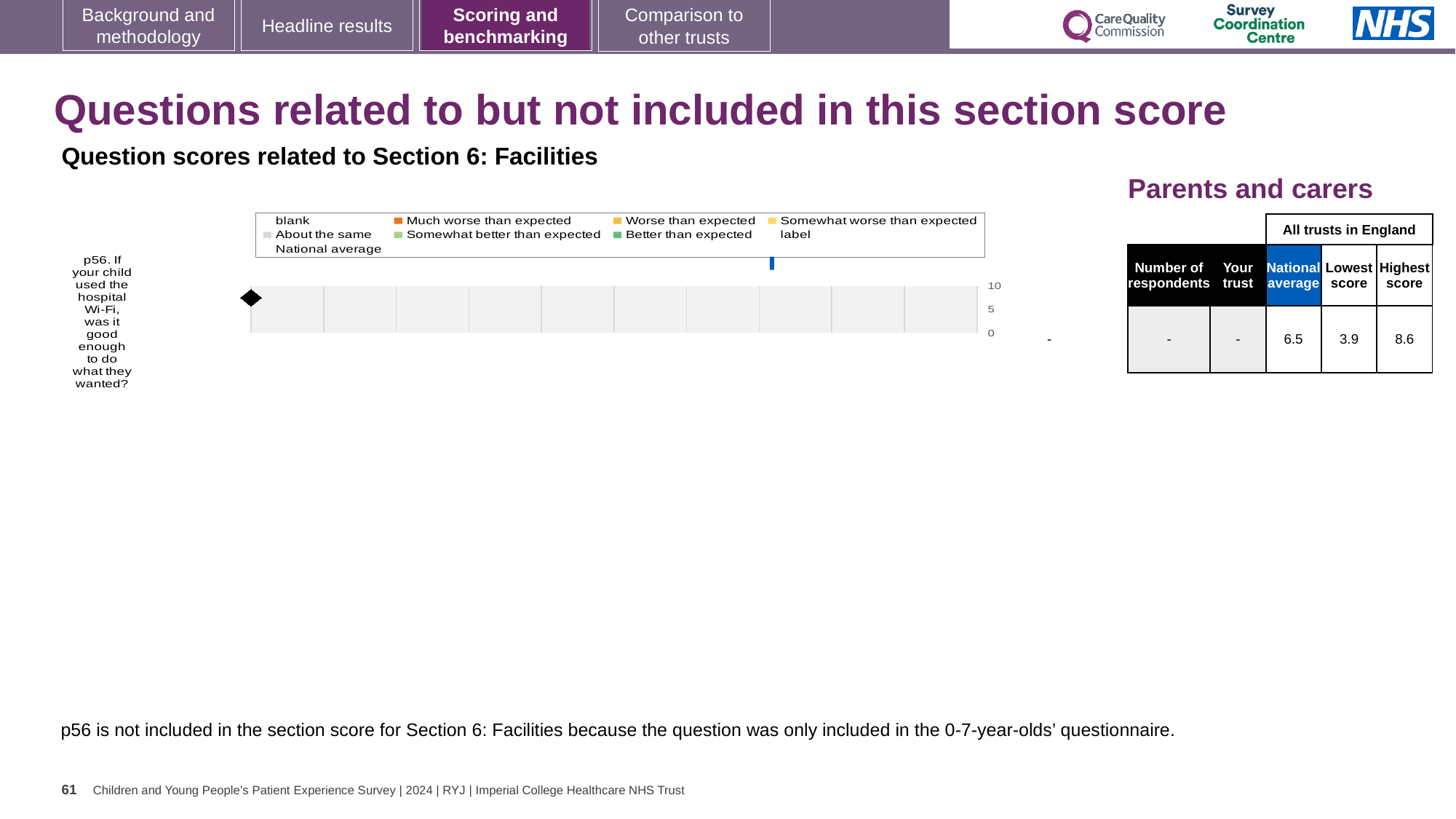
Is a trust score bar plotted for p56 on the chart? No What kind of chart is shown on the slide? bar chart What is the highest value shown on the chart's vertical axis? 10 Which question number is plotted on the chart? p56 How many question categories are plotted on the chart? 1